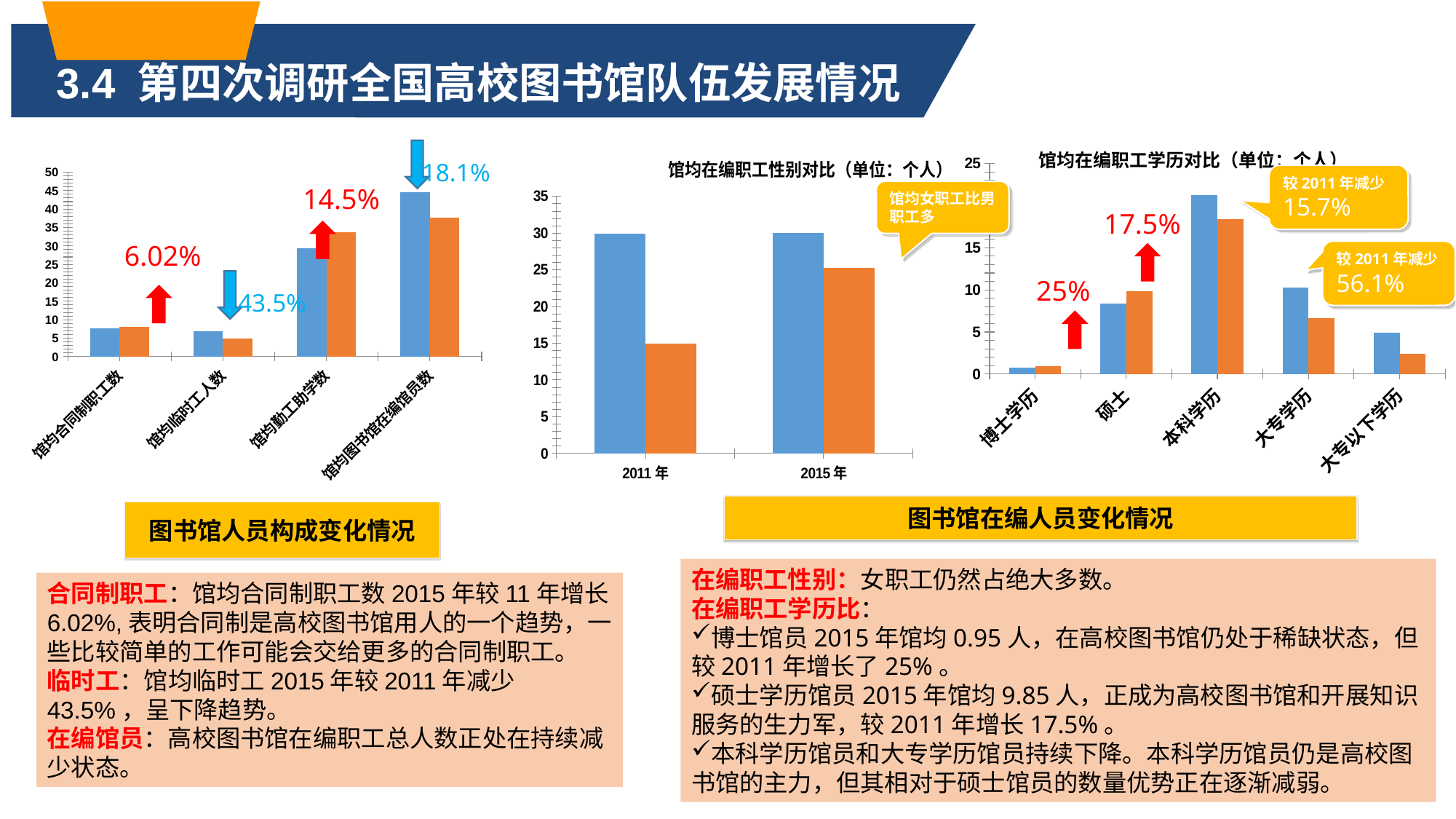
What kind of chart is the middle chart titled 馆均在编职工性别对比（单位：个人）? bar chart In the left chart, is the blue bar for 馆均图书馆在编馆员数 greater or less than 40? greater In the right chart 馆均在编职工学历对比, what percentage change is annotated above the 硕士 bars? 17.5% In the right chart 馆均在编职工学历对比, is the orange bar for 本科学历 greater or less than 15? greater How many categories are shown on the x axis of the left chart (the one starting with 馆均合同制职工数)? 4 In the right chart 馆均在编职工学历对比, which category has the tallest bars? 本科学历 In the middle chart 馆均在编职工性别对比, which year has the taller orange bar, 2011年 or 2015年? 2015年 In the right chart 馆均在编职工学历对比, which category has the shortest bars? 博士学历 In the middle chart 馆均在编职工性别对比, what value does the orange bar for 2011年 reach? 15 In the middle chart 馆均在编职工性别对比, what value does the blue bar for 2015年 reach? 30 How many categories are shown on the x axis of the right chart 馆均在编职工学历对比? 5